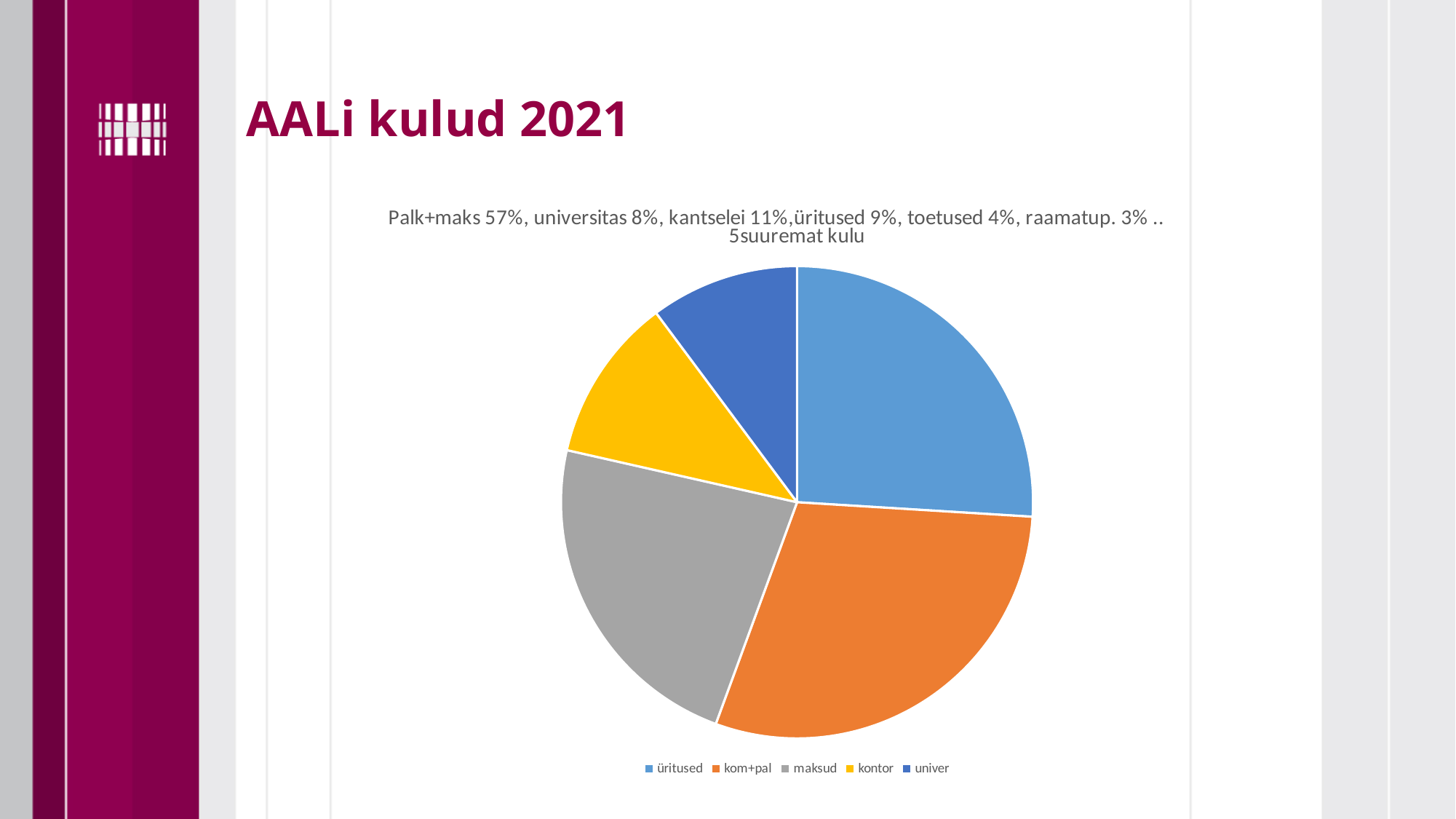
What kind of chart is shown on the slide? pie chart Which category has the smallest slice in the pie chart? univer Which category has the largest slice in the pie chart? kom+pal Which slice is larger, kom+pal or kontor? kom+pal Which category is shown in orange in the pie chart? kom+pal Which slice is larger, kontor or univer? kontor How many slices does the pie chart have? 5 What is the title of the slide? AALi kulud 2021 How many entries does the legend of the pie chart list? 5 Which slice is larger, maksud or kontor? maksud